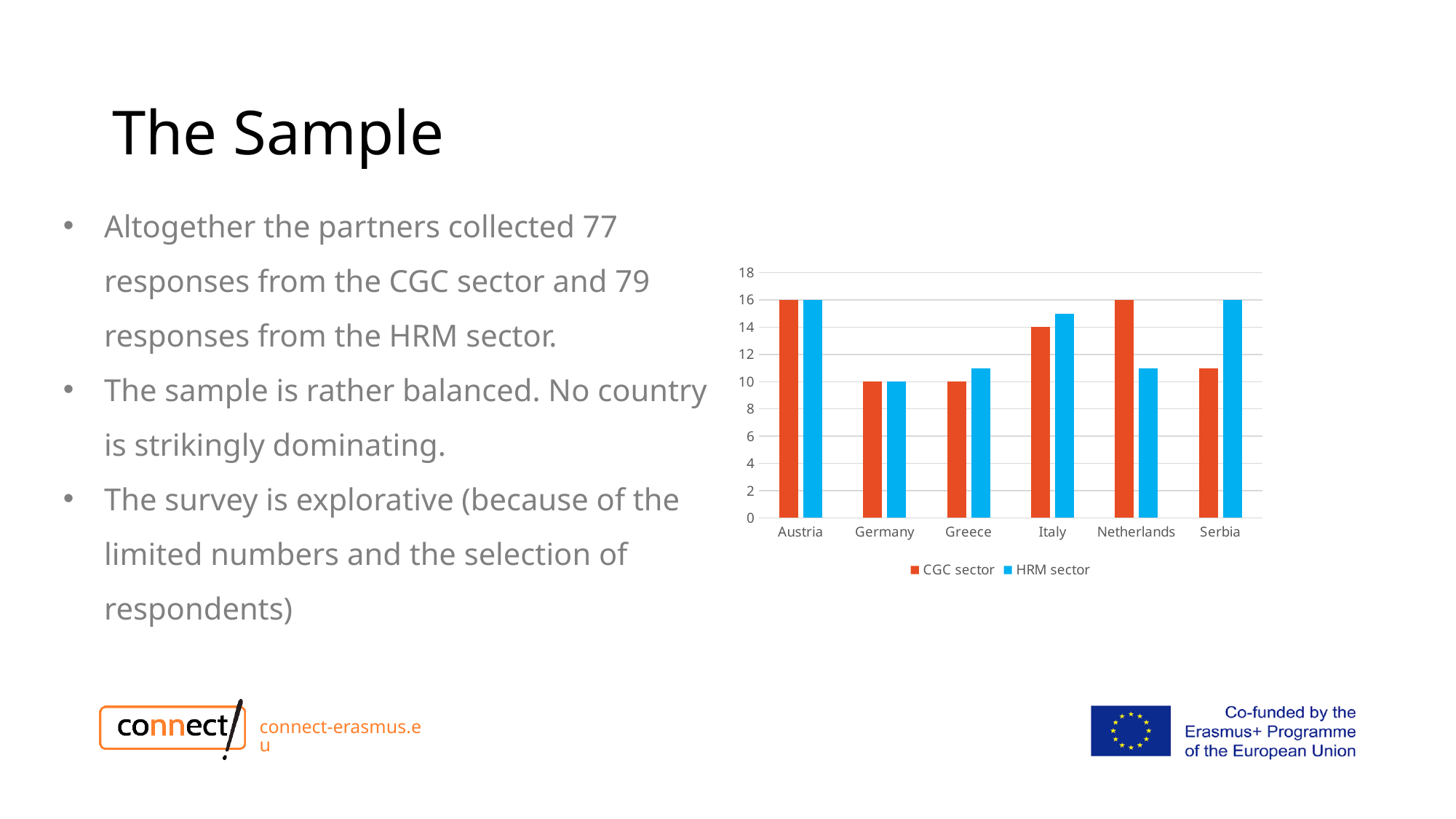
Which is larger in the Netherlands, the CGC sector value or the HRM sector value? CGC sector Which country has the lowest CGC sector value? Germany and Greece (both 10) What kind of chart is shown on the slide? bar chart What is the difference between the CGC sector values for the Netherlands and Germany? 6 Is the value for the HRM sector in the Netherlands greater or less than 12? less What is the value for the CGC sector in Italy? 14 Is the value for the HRM sector in Greece greater or less than 10? greater What is the value for the HRM sector in Serbia? 16 How many countries are shown on the x axis of the chart? 6 What is the value for the HRM sector in Germany? 10 What is the value for the CGC sector in Austria? 16 How many series does the chart legend list? 2